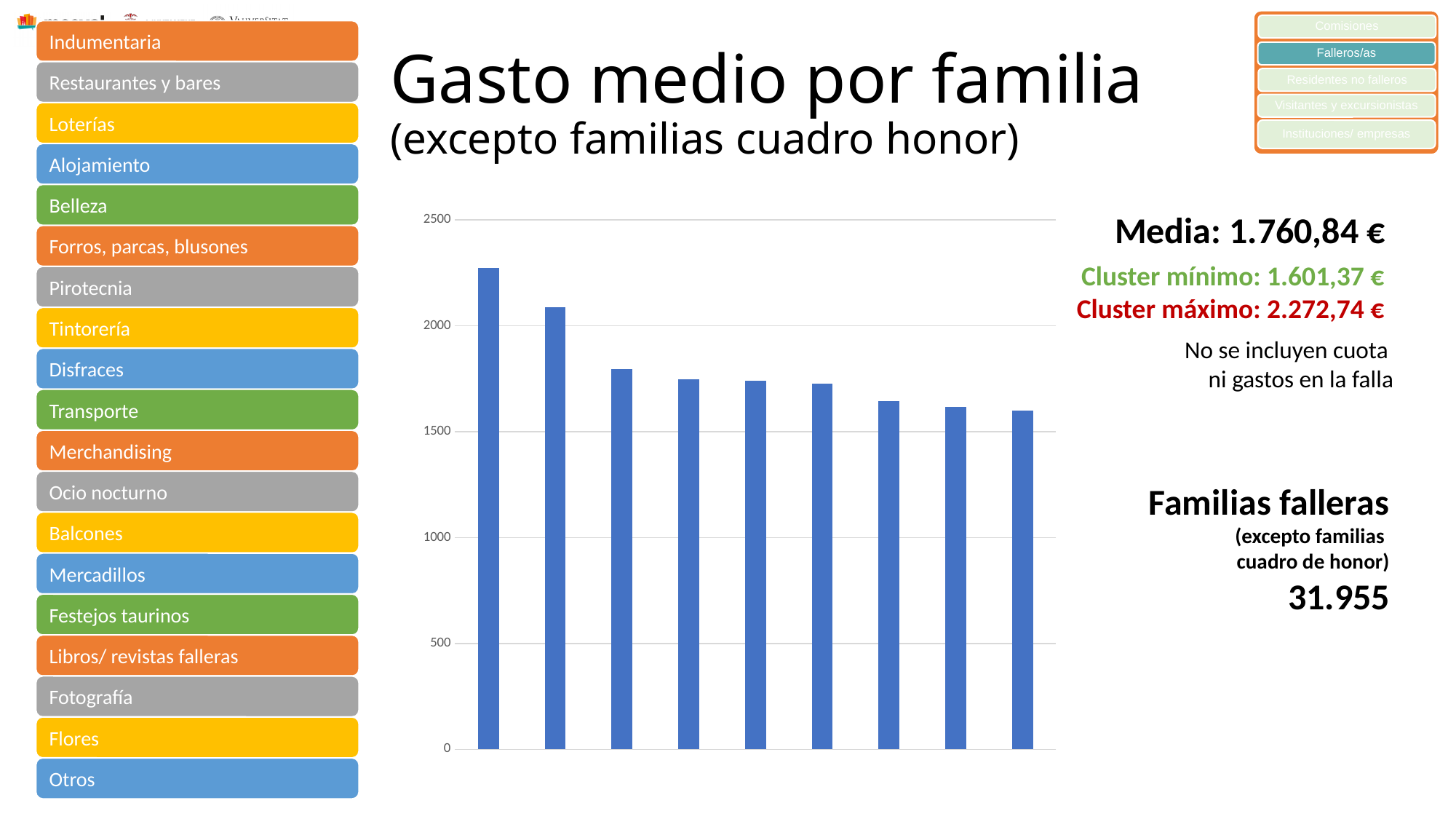
Is the value of the leftmost bar greater or less than 2000? greater What is the title of the slide containing the chart? Gasto medio por familia (excepto familias cuadro honor) What kind of chart is shown on the slide? bar chart Do the bar values rise or fall from left to right across the chart? fall Is the value of the rightmost bar greater or less than 1500? greater Is the value of the fourth bar from the left greater or less than 1500? greater How many bars are plotted in the chart? 9 Which is larger, the leftmost bar or the rightmost bar? the leftmost bar What is the highest value shown on the vertical axis of the chart? 2500 Which bar is the highest in the chart? the leftmost (first) bar